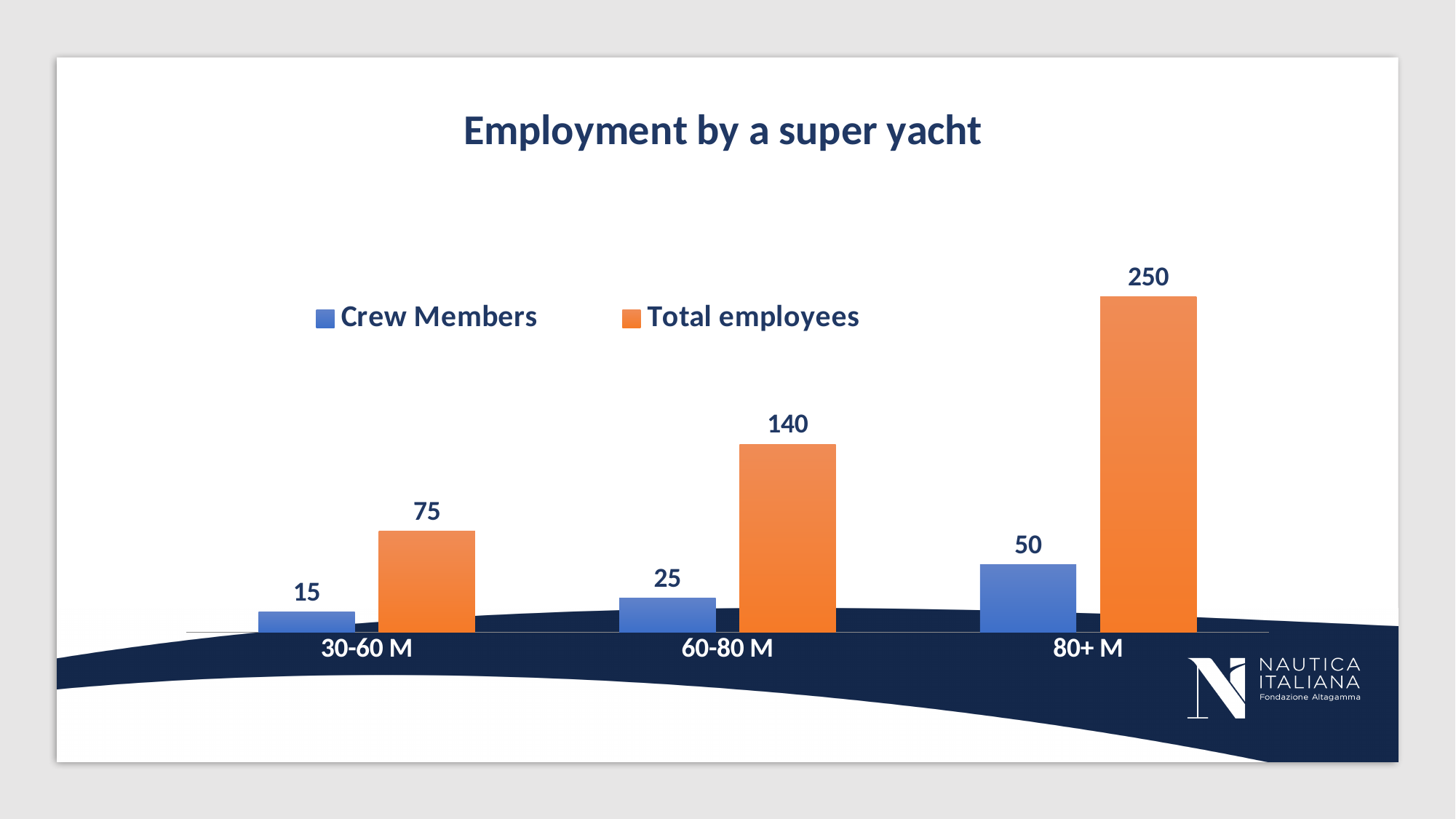
Which is larger: Crew Members for 80+ M or Total employees for 30-60 M? Total employees for 30-60 M What is the value for Crew Members in the 80+ M category? 50 Which category has the lowest value for Crew Members? 30-60 M What is the difference between Total employees and Crew Members in the 80+ M category? 200 What is the value for Total employees in the 60-80 M category? 140 What kind of chart is shown on the slide? Bar chart Do the Total employees values rise or fall from 30-60 M to 80+ M? Rise What is the value for Crew Members in the 30-60 M category? 15 What is the difference in Total employees between the 60-80 M and 30-60 M categories? 65 How many series does the legend list? 2 How many categories are shown on the x axis? 3 Which category has the highest value for Total employees? 80+ M